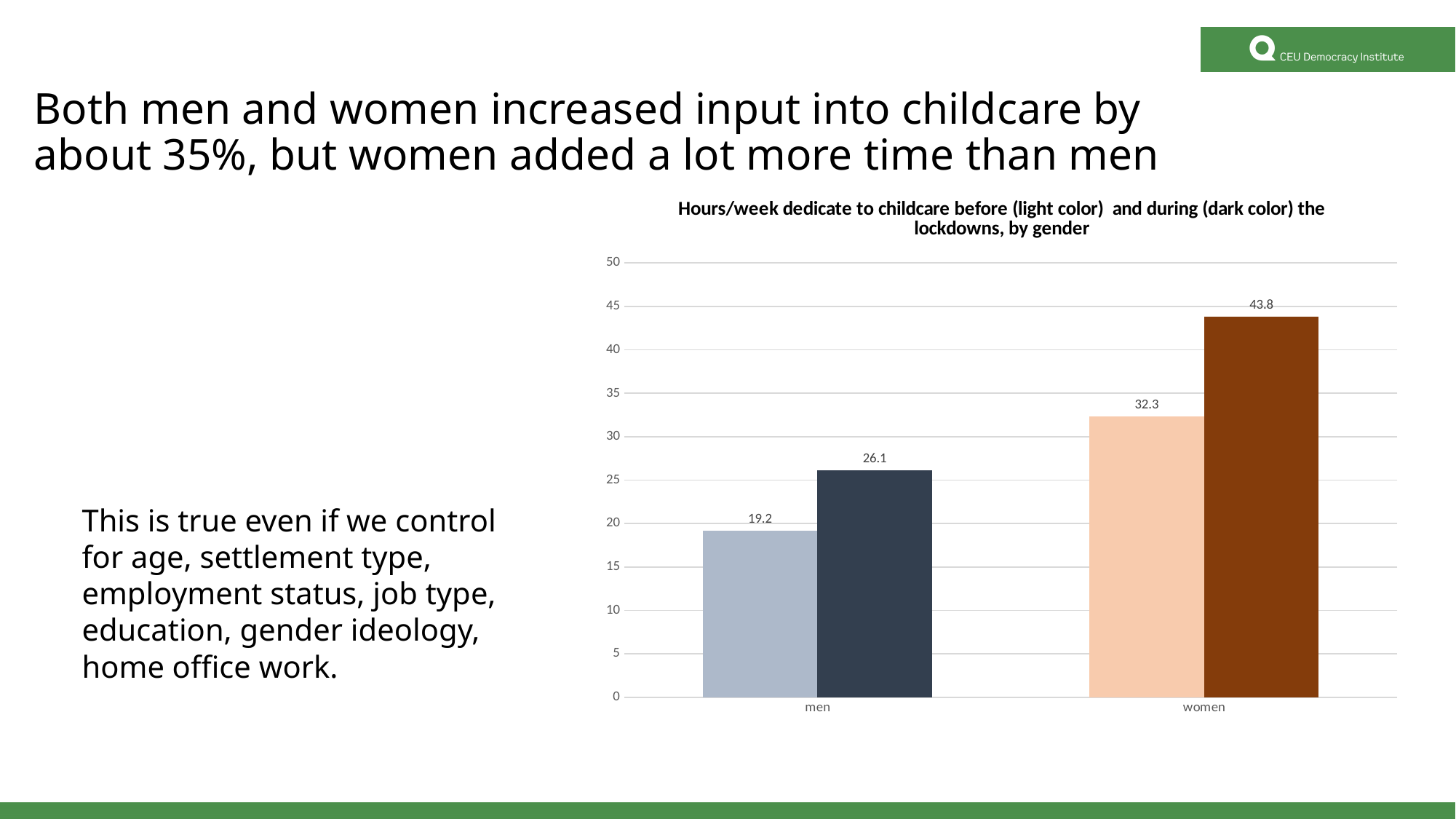
How many hours per week did women dedicate to childcare before the lockdowns? 32.3 Which bar shows the lowest value in the chart? men before the lockdowns Which is larger: men's childcare hours during the lockdowns or women's childcare hours before the lockdowns? women's childcare hours before the lockdowns By how many hours per week did men's childcare time increase from before to during the lockdowns? 6.9 By how many hours per week did women's childcare time increase from before to during the lockdowns? 11.5 What kind of chart is shown on the slide? bar chart How many hours per week did men dedicate to childcare before the lockdowns? 19.2 How many hours per week did men dedicate to childcare during the lockdowns? 26.1 According to the chart title, what do the light-colored bars represent? hours/week dedicated to childcare before the lockdowns How many hours per week did women dedicate to childcare during the lockdowns? 43.8 How many gender categories are shown on the x axis of the chart? 2 Which bar shows the highest value in the chart? women during the lockdowns